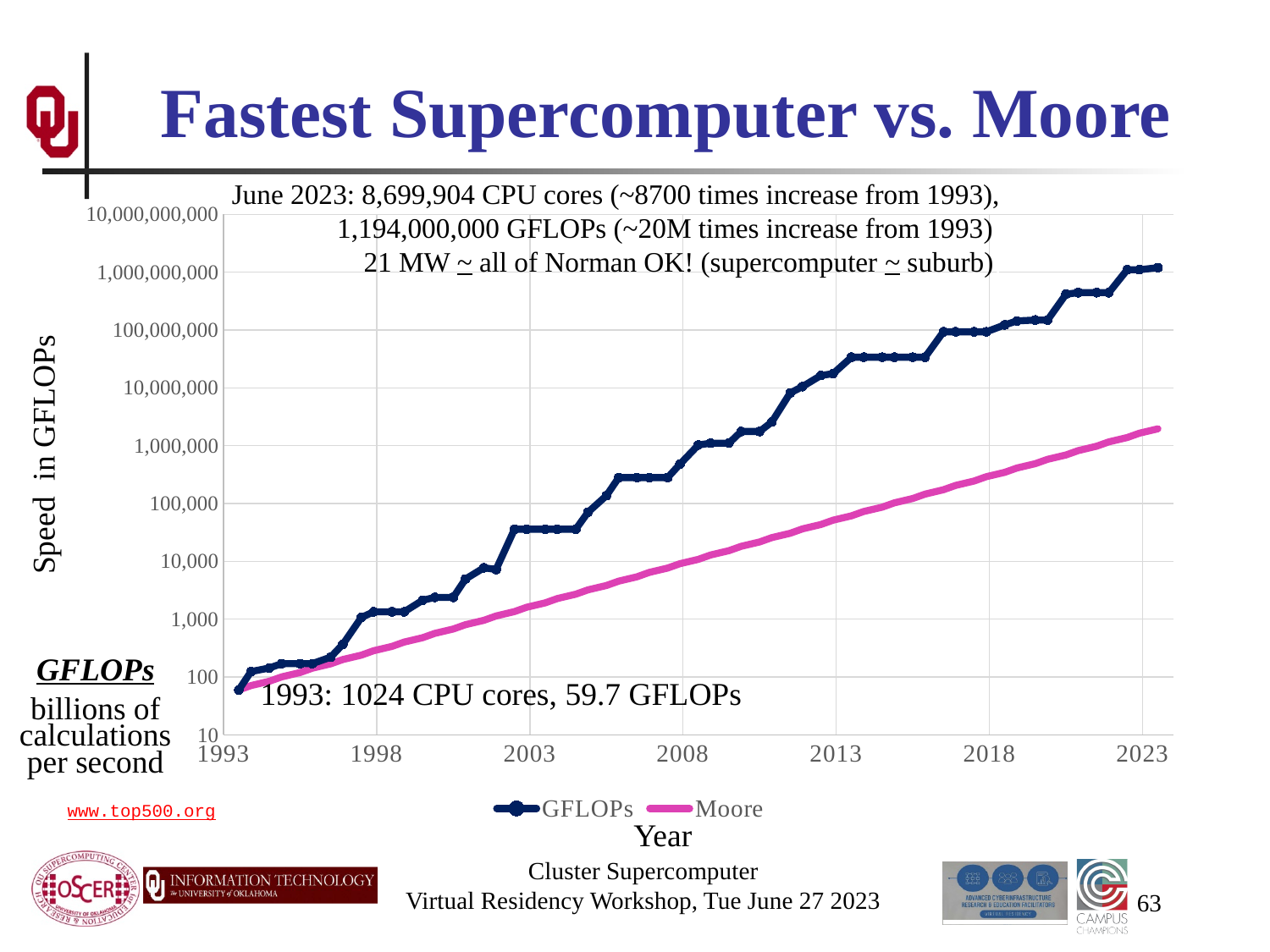
Is the GFLOPs value in 2023 greater or less than 1,000,000,000? greater In 2023, which series has the higher value, GFLOPs or Moore? GFLOPs According to the annotation, what was the speed of the fastest supercomputer in June 2023? 1,194,000,000 GFLOPs How many series does the chart's legend list? 2 Does the GFLOPs series rise or fall from 1993 to 2023? rise Is the Moore value in 2023 greater or less than 10,000,000? less What is the title of the x axis? Year According to the annotation, what was the speed of the fastest supercomputer in 1993? 59.7 GFLOPs Is the Moore value in 2013 greater or less than 100,000? less What kind of chart is shown on the slide? line chart What are the two series named in the legend? GFLOPs and Moore